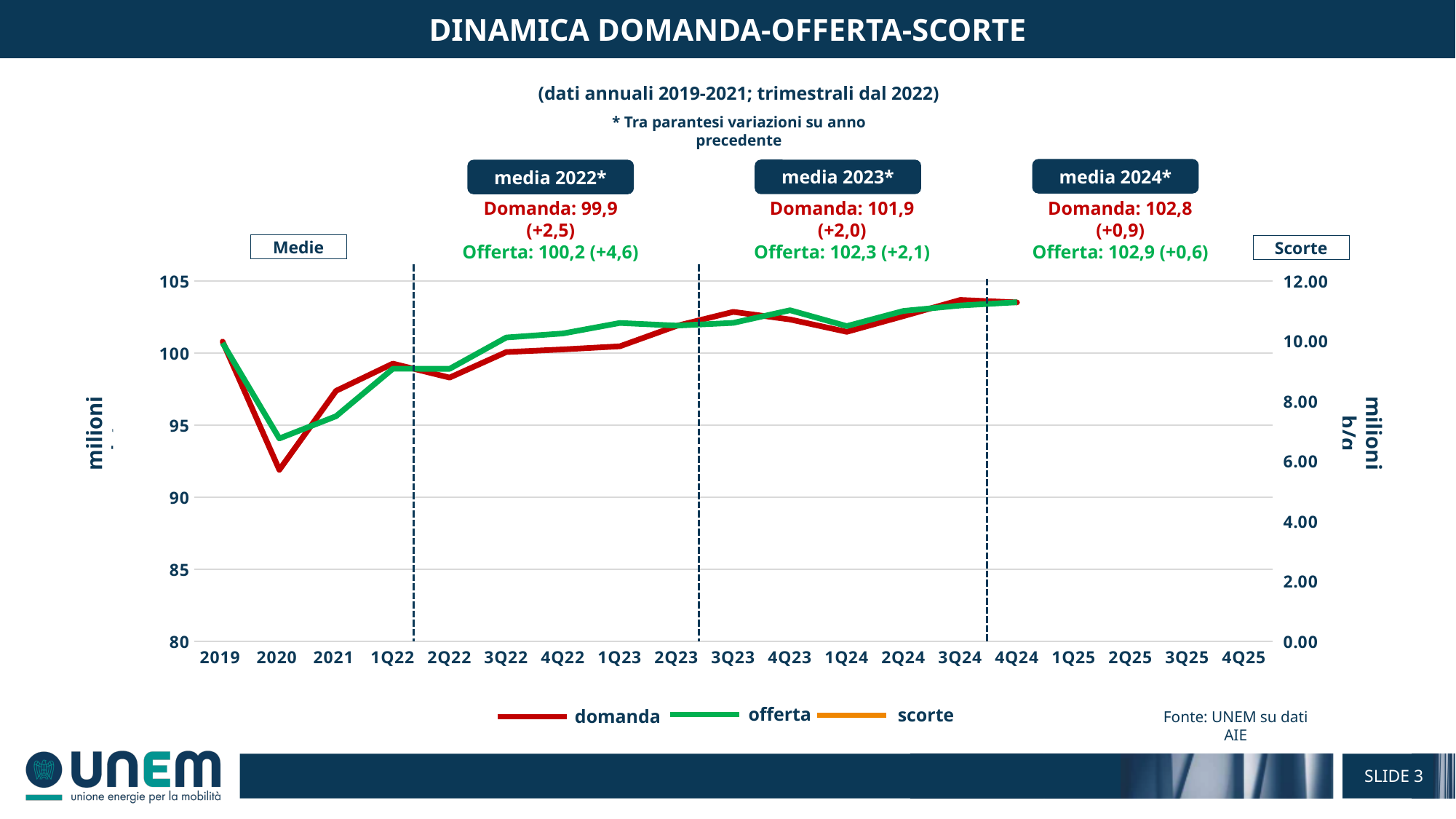
In 3Q22, which is larger: domanda or offerta? offerta In which year or quarter does the offerta line reach its lowest value? 2020 How many categories are shown on the x axis? 19 What kind of chart is shown on the slide? line chart In which year or quarter does the domanda line reach its lowest value? 2020 Is the value of domanda in 2020 greater or less than 95? less How many series does the legend list? 3 Is the value of domanda in 3Q24 greater or less than 100? greater Is the value of domanda in 2019 greater or less than 100? greater Does the domanda line generally rise or fall from 2020 to 3Q24? rise In 2021, which is larger: domanda or offerta? domanda According to the annotation, what is the media 2023 value for Domanda? 101,9